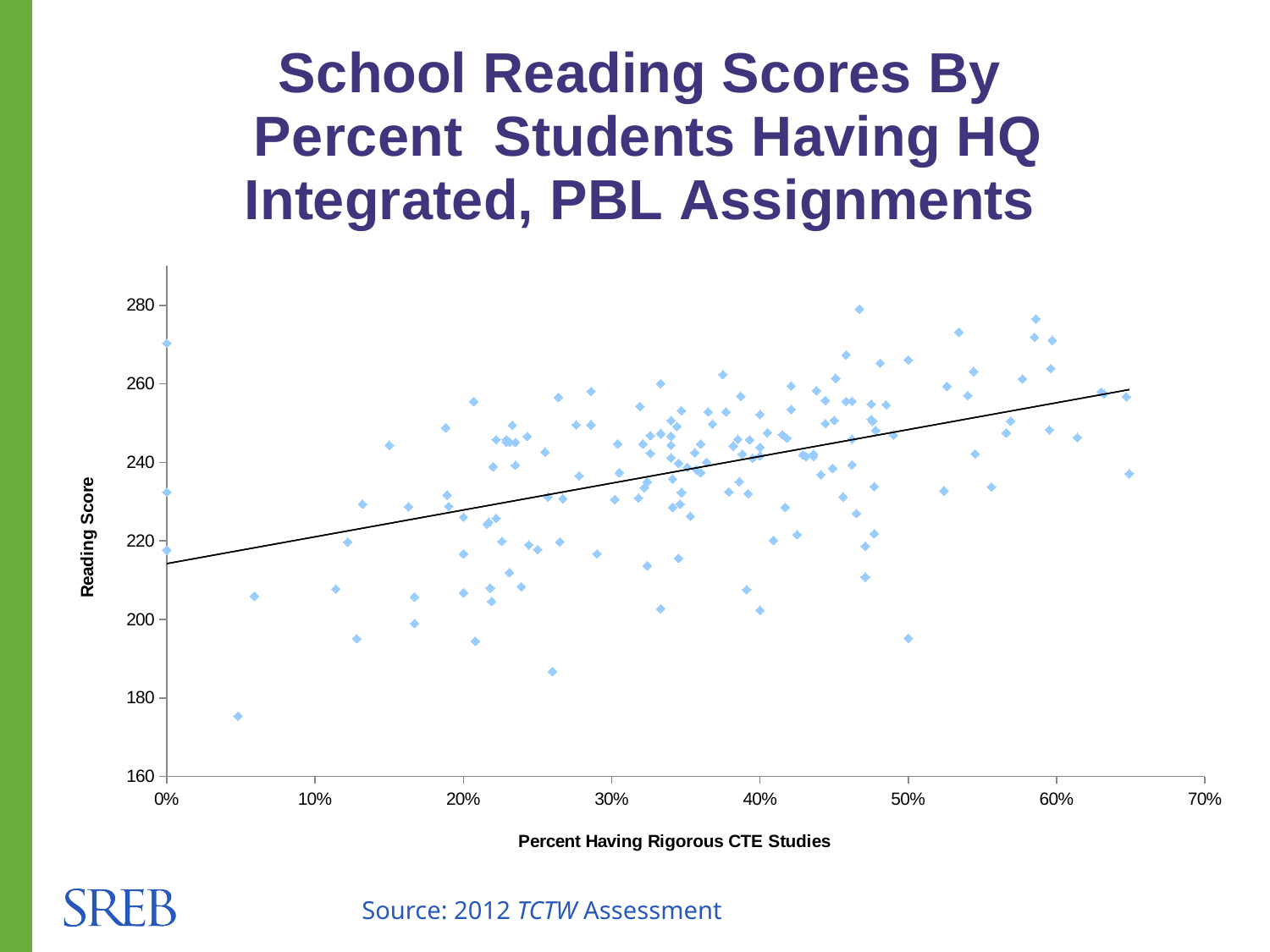
Is the percent value of the lowest-scoring point greater or less than 10%? less Is the highest plotted reading score greater or less than 260? greater What is the lowest tick value shown on the vertical axis? 160 What is the label of the horizontal axis? Percent Having Rigorous CTE Studies What kind of chart is shown on the slide? scatter chart What is the label of the vertical axis? Reading Score What is the highest tick value shown on the vertical axis? 280 Is the trend line's value at 0% greater or less than 220? less Does the trend line show reading scores rising or falling as the percent having rigorous CTE studies increases? rising What is the highest tick value shown on the horizontal axis? 70%